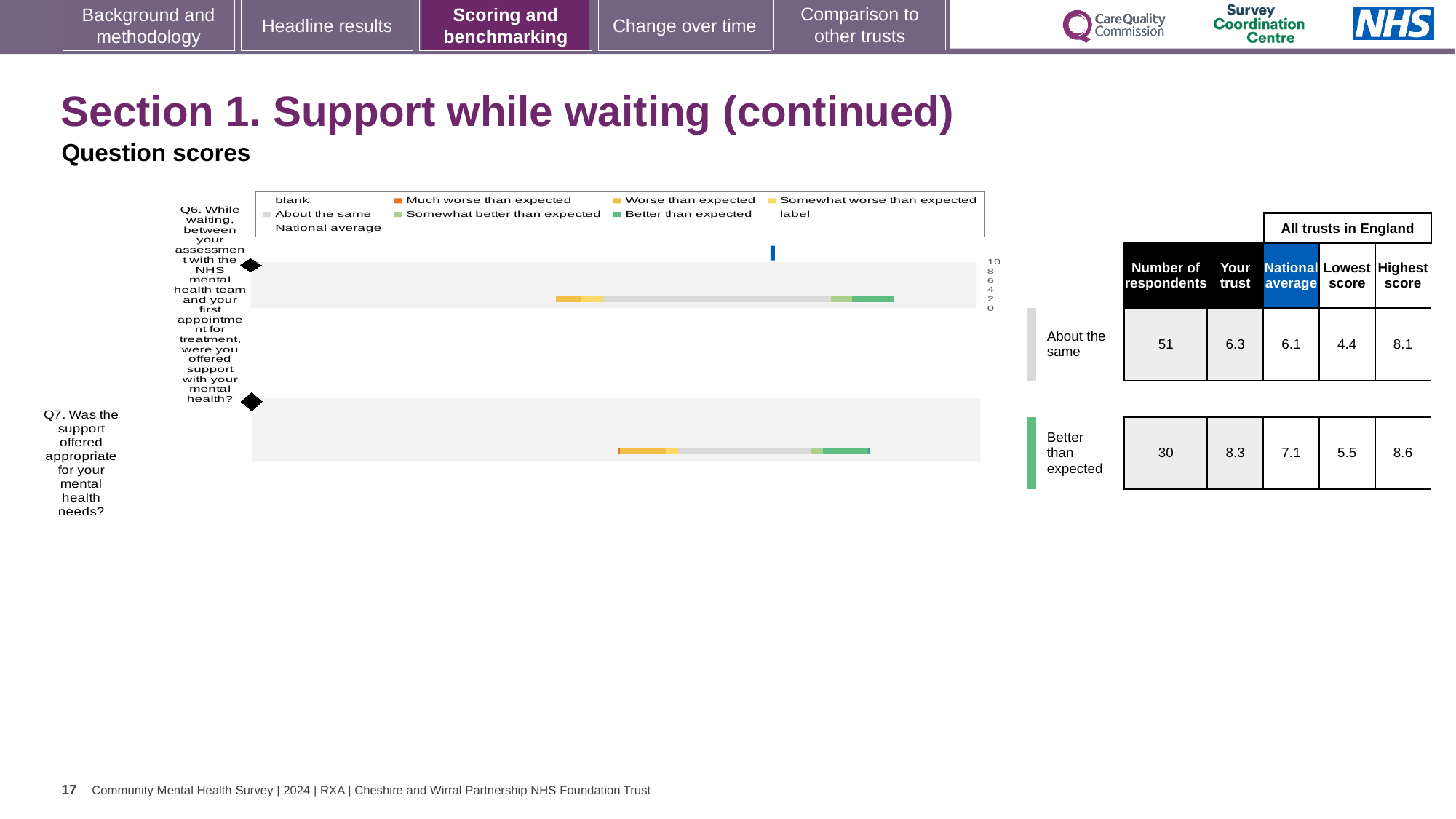
What is the lowest score among all trusts in England for Q6? 4.4 What is the national average score for Q6? 6.1 How many questions are plotted in the chart on this slide? 2 What kind of chart is used to show the question scores on this slide? bar chart What is the 'Your trust' score for Q7 (was the support offered appropriate for your mental health needs)? 8.3 What is the 'Your trust' score for Q6 (support while waiting between assessment and first appointment)? 6.3 How many respondents answered Q7? 30 Which benchmark category is the trust's Q7 score placed in? Better than expected Which question has the higher 'Your trust' score, Q6 or Q7? Q7 What is the difference between the trust's score and the national average for Q7? 1.2 What is the highest score among all trusts in England for Q7? 8.6 What is the national average score for Q7? 7.1